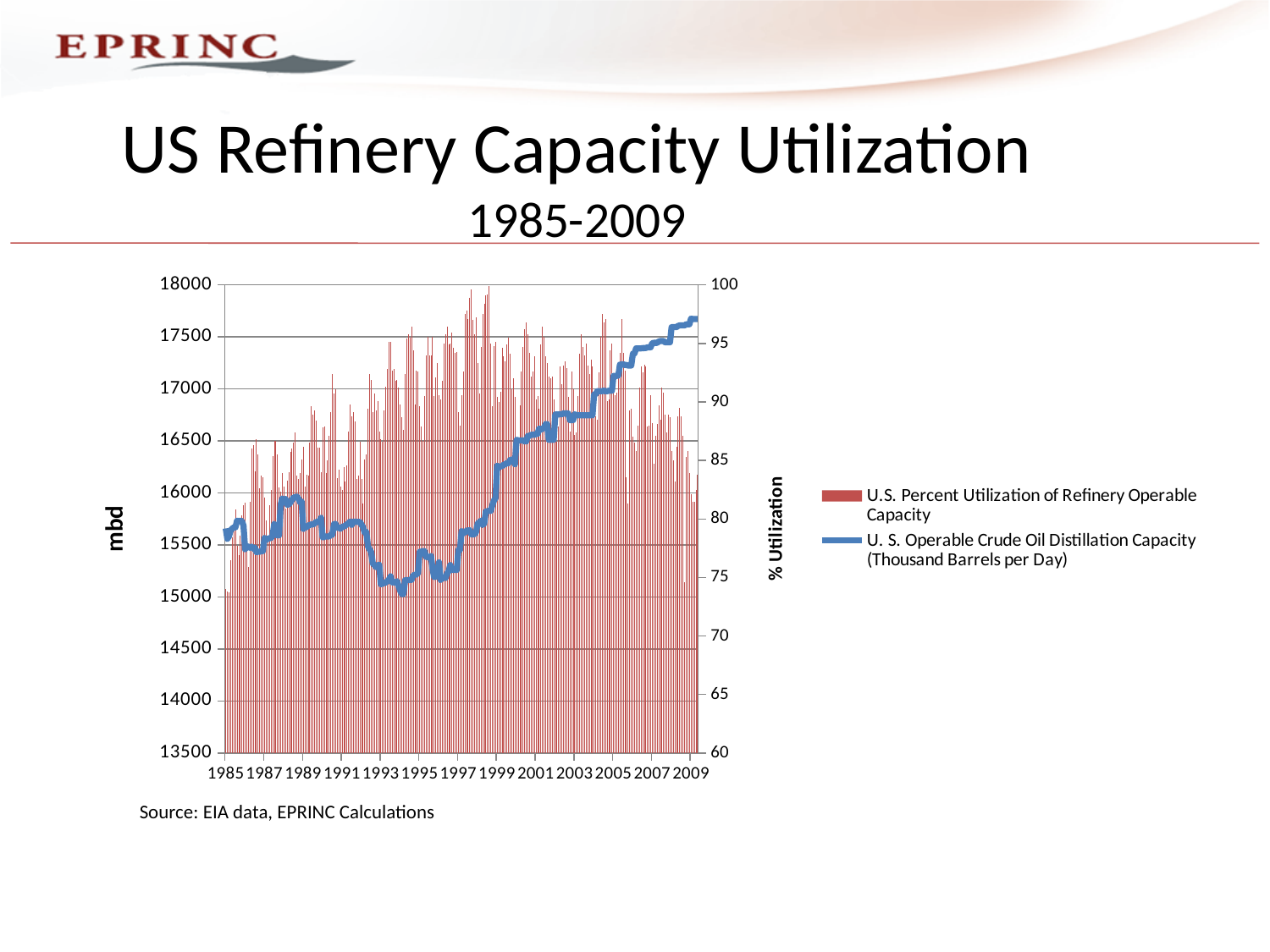
What is the label of the left vertical axis? mbd Which is larger, the U.S. Operable Crude Oil Distillation Capacity in 2009 or in 1994? 2009 Is the U.S. Operable Crude Oil Distillation Capacity in 1994 greater or less than 15500? less Is the U.S. Operable Crude Oil Distillation Capacity in 2009 greater or less than 17500? greater Is the U.S. Operable Crude Oil Distillation Capacity in 1985 greater or less than 15500? greater Does the U.S. Operable Crude Oil Distillation Capacity line rise or fall overall from 1985 to 2009? Rise Which series is drawn as a blue line? U. S. Operable Crude Oil Distillation Capacity (Thousand Barrels per Day) How many series does the legend list? 2 What is the title of the chart on the slide? US Refinery Capacity Utilization 1985-2009 What kind of chart is shown on the slide? A combined bar and line chart